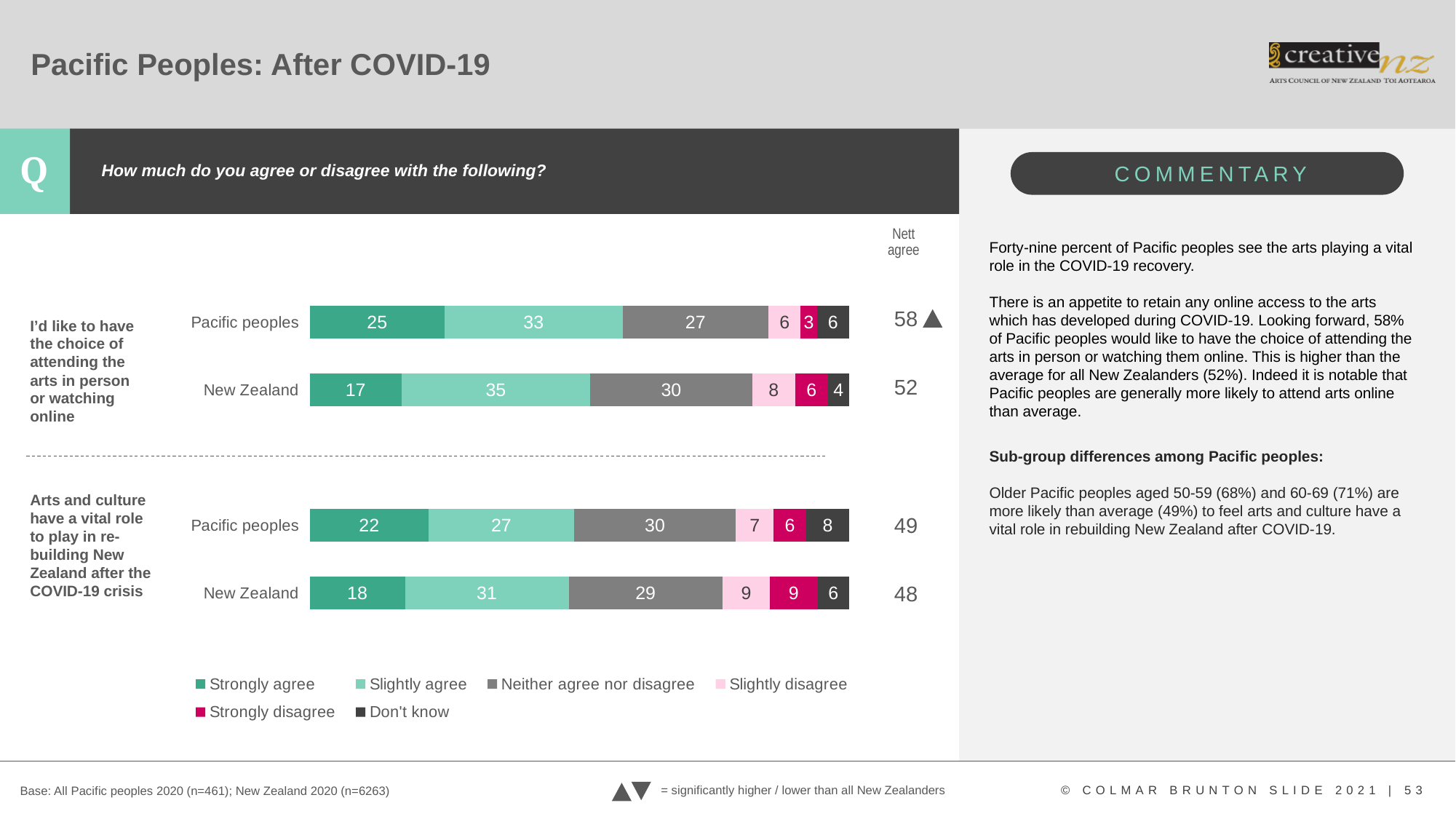
How many series does the legend list? 6 Which has the larger Strongly agree value on the statement about arts and culture having a vital role in re-building New Zealand: Pacific peoples or New Zealand? Pacific peoples What is the Strongly agree value for Pacific peoples on the statement about having the choice of attending the arts in person or watching online? 25 What kind of chart is shown on the slide? Stacked bar chart What is the Nett agree figure for Pacific peoples on the statement that arts and culture have a vital role in re-building New Zealand after the COVID-19 crisis? 49 What is the total of the Strongly agree and Slightly agree segments for Pacific peoples on the statement about arts and culture having a vital role in re-building New Zealand? 49 What is the difference between the Nett agree figures for Pacific peoples and New Zealand on the statement about having the choice of attending the arts in person or watching online? 6 Which of the four bars has the highest Nett agree figure? Pacific peoples, choice of attending the arts in person or watching online (58) What is the Slightly agree value for New Zealand on the statement about having the choice of attending the arts in person or watching online? 35 What is the Don't know value for New Zealand on the statement that arts and culture have a vital role in re-building New Zealand after the COVID-19 crisis? 6 What is the Strongly disagree value for Pacific peoples on the statement about having the choice of attending the arts in person or watching online? 3 How many bars are plotted on the chart? 4